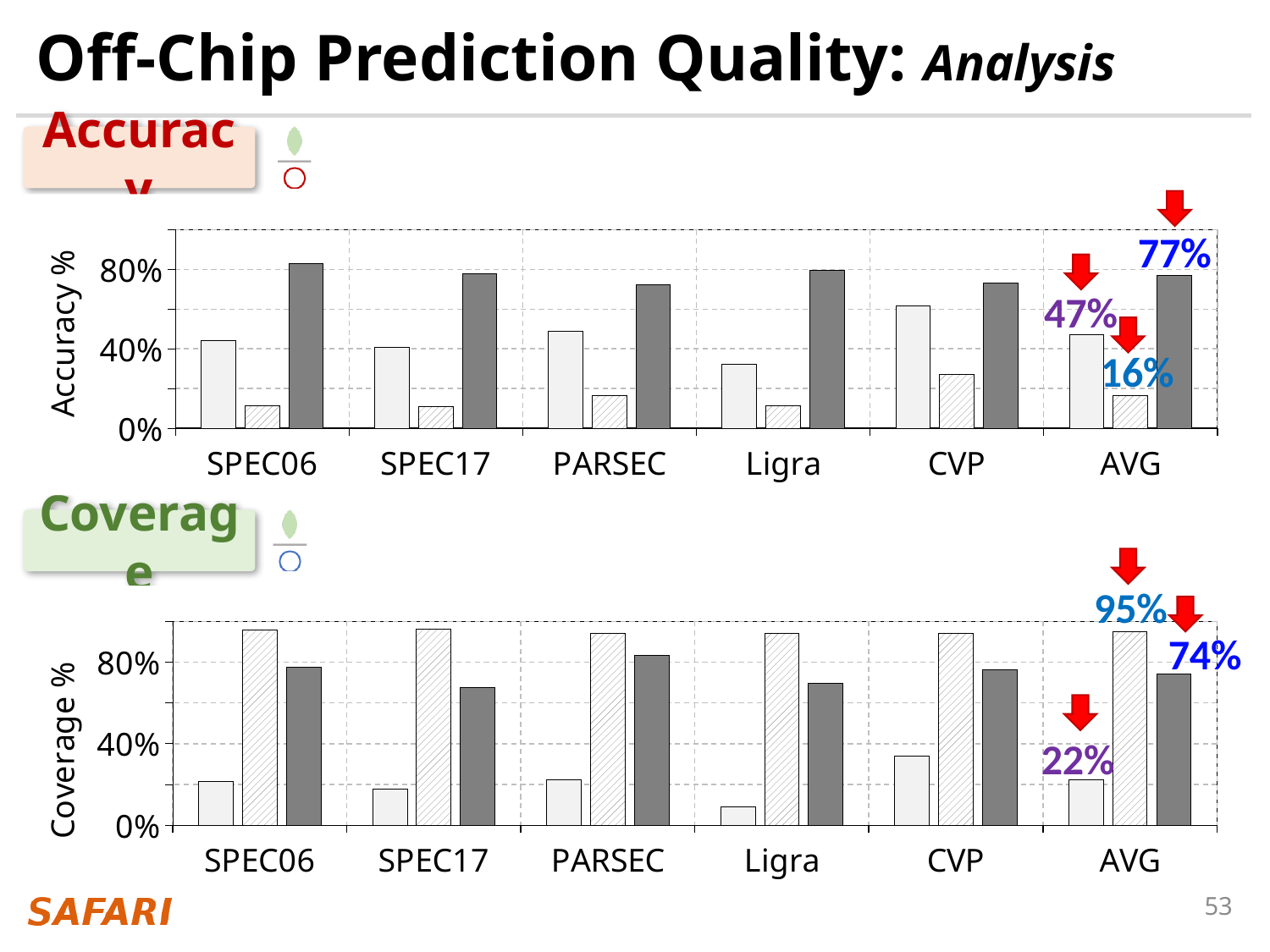
In the Coverage chart (bottom), what is the labeled value of the light (leftmost) bar for AVG? 22% In the Coverage chart (bottom), what is the difference between the hatched AVG bar and the dark gray AVG bar? 21% In the Accuracy chart (top), what is the labeled value of the light (leftmost) bar for AVG? 47% In the Coverage chart (bottom), what is the labeled value of the dark gray bar for AVG? 74% In the Coverage chart (bottom), what is the labeled value of the hatched bar for AVG? 95% What kind of chart is the Coverage chart (bottom)? bar chart In the Coverage chart (bottom), which category has the lowest light (leftmost) bar? Ligra In the Accuracy chart (top), is the light (leftmost) bar for Ligra greater or less than 40%? less In the Accuracy chart (top), what is the labeled value of the hatched bar for AVG? 16% How many categories are shown on the x axis of the Accuracy chart (top)? 6 In the Accuracy chart (top), what is the labeled value of the dark gray bar for AVG? 77% In the Accuracy chart (top), how much higher is the dark gray AVG bar than the light AVG bar? 30%